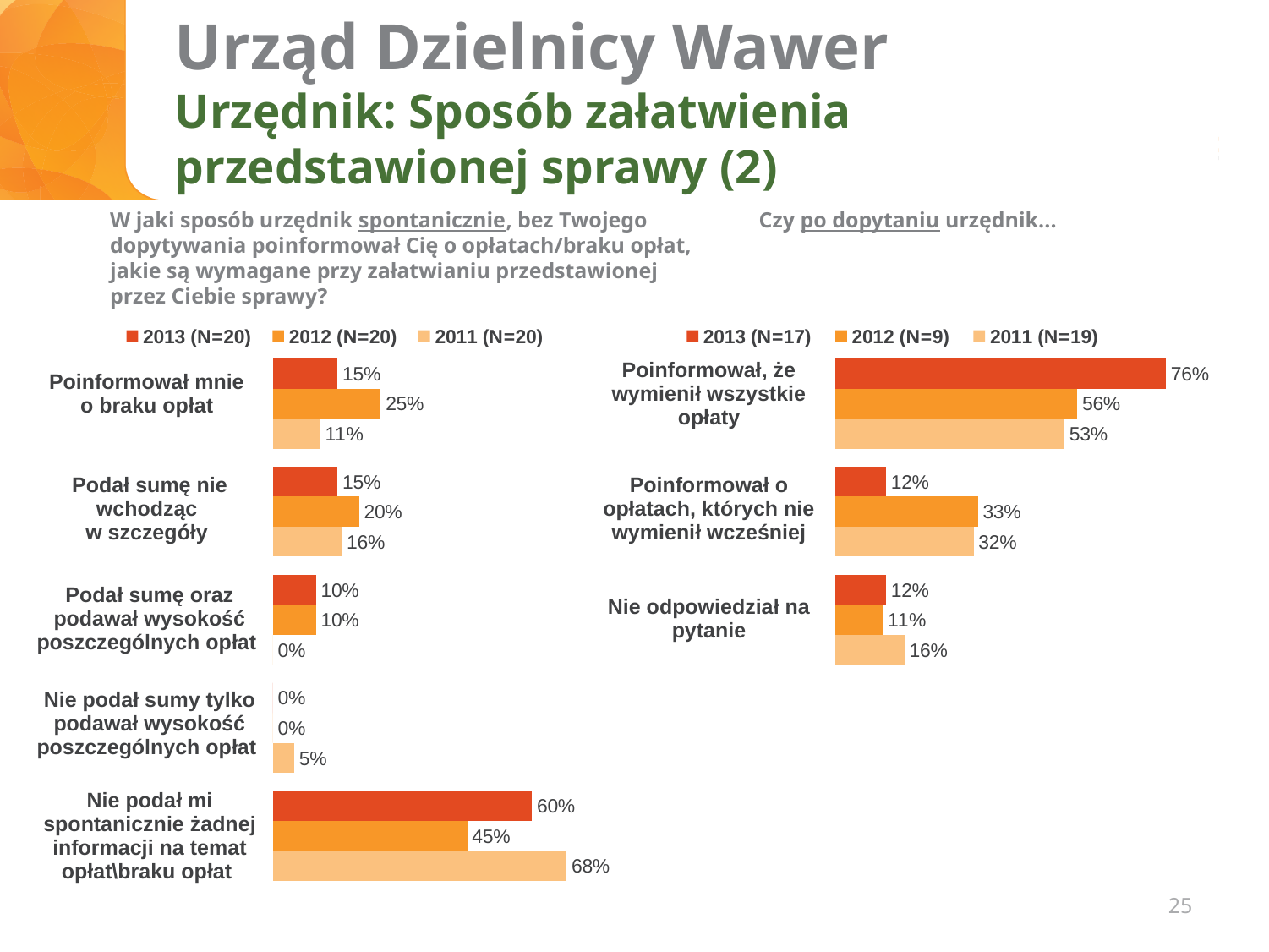
In the right chart, what is the difference between the 2013 (N=17) and 2011 (N=19) values for 'Poinformował, że wymienił wszystkie opłaty'? 23% In the left chart, which category has the highest 2011 (N=20) value? Nie podał mi spontanicznie żadnej informacji na temat opłat\braku opłat What kind of chart is the right chart? Bar chart In the right chart, what sample size is shown in the legend for 2012? N=9 In the right chart, what is the 2011 (N=19) value for 'Nie odpowiedział na pytanie'? 16% How many categories does the left chart show? 5 In the left chart, what is the 2012 (N=20) value for 'Poinformował mnie o braku opłat'? 25% How many series does the legend of the right chart list? 3 In the right chart, which category has the lowest 2012 (N=9) value? Nie odpowiedział na pytanie In the right chart, what is the 2013 (N=17) value for 'Poinformował, że wymienił wszystkie opłaty'? 76% In the left chart, what is the 2013 (N=20) value for 'Nie podał mi spontanicznie żadnej informacji na temat opłat\braku opłat'? 60% In the left chart, which is larger for 'Podał sumę nie wchodząc w szczegóły': the 2012 (N=20) value or the 2011 (N=20) value? 2012 (N=20)